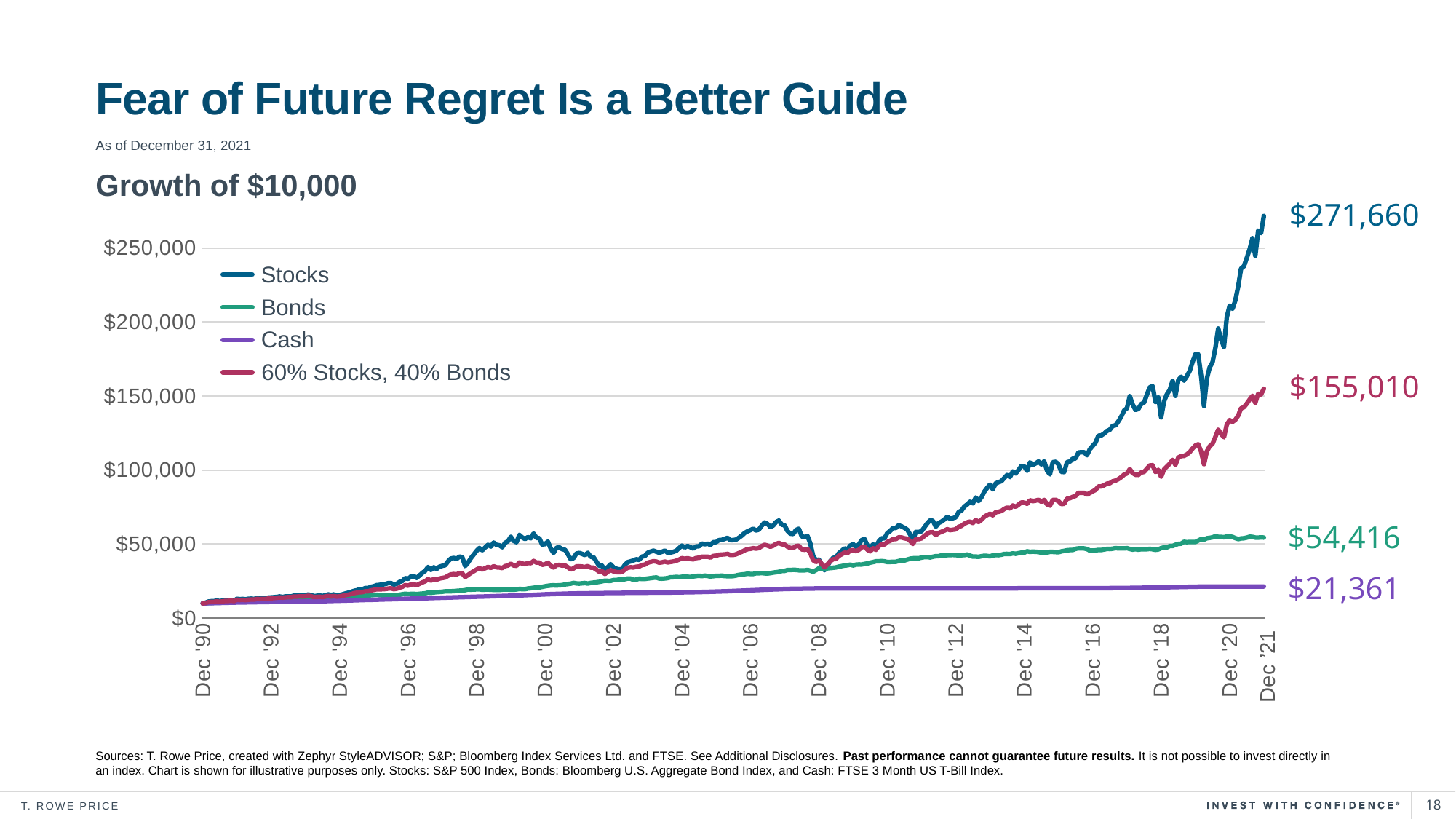
What kind of chart is shown on the slide? Line chart How many series does the legend list? 4 What is the difference between the ending values of Bonds and Cash? $33,055 What is the ending value of the Stocks line at Dec '21? $271,660 Which has a larger ending value, Bonds or Cash? Bonds What is the difference between the ending values of Stocks and 60% Stocks, 40% Bonds? $116,650 Which series has the highest ending value at Dec '21? Stocks What is the ending value of the Bonds line at Dec '21? $54,416 What is the ending value of the Cash line at Dec '21? $21,361 What is the ending value of the 60% Stocks, 40% Bonds line at Dec '21? $155,010 Is the value of the Stocks line at Dec '14 greater or less than $150,000? less Which series has the lowest ending value at Dec '21? Cash